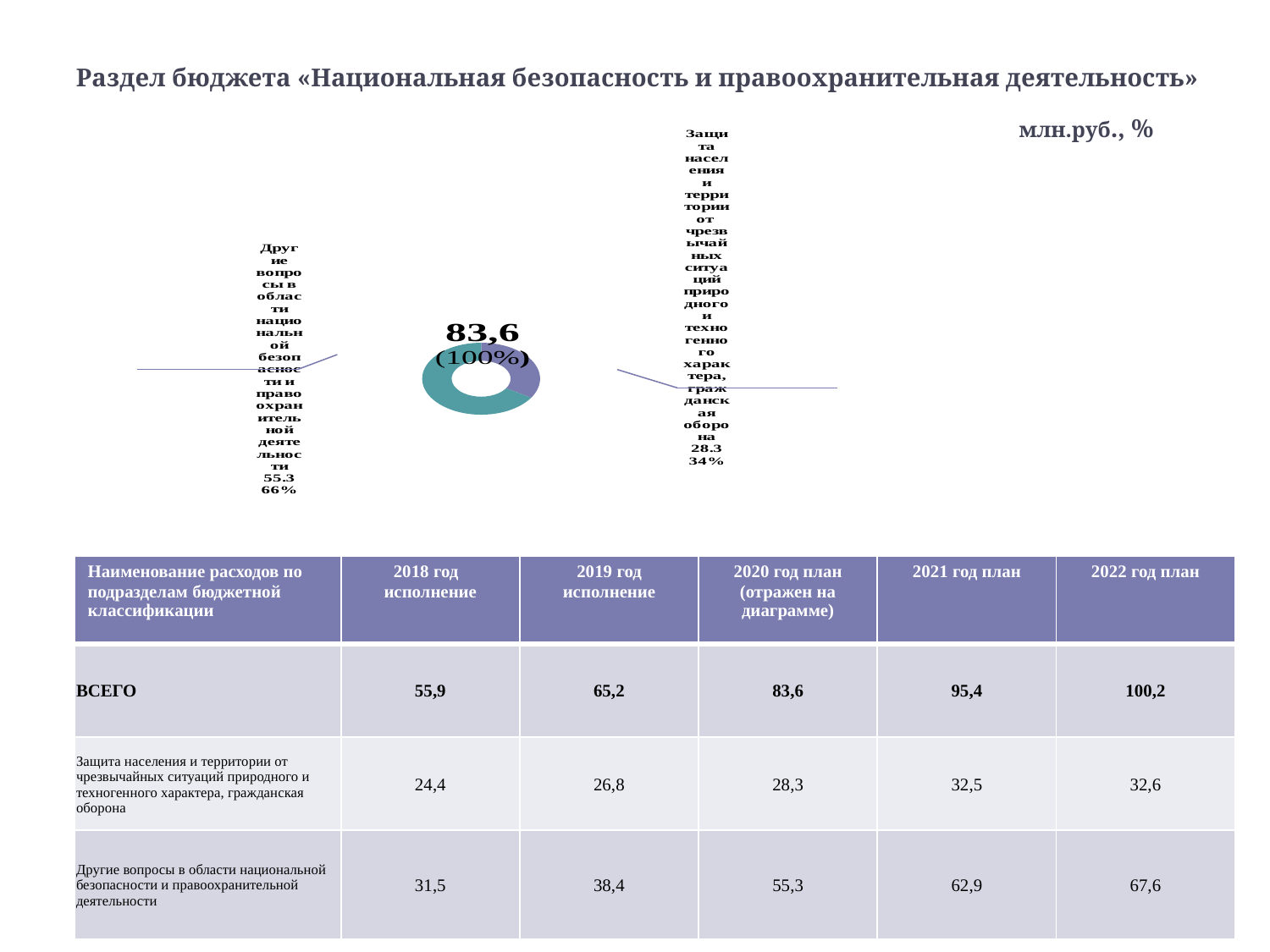
Which slice of the doughnut chart is the smallest? Защита населения и территории от чрезвычайных ситуаций природного и техногенного характера, гражданская оборона What share of the doughnut does 'Защита населения и территории от чрезвычайных ситуаций природного и техногенного характера, гражданская оборона' take? 34% What total value is printed in the centre of the doughnut chart? 83,6 (100%) What value is shown for the slice 'Другие вопросы в области национальной безопасности и правоохранительной деятельности'? 55.3 What share of the doughnut does 'Другие вопросы в области национальной безопасности и правоохранительной деятельности' take? 66% What kind of chart is shown on the slide? doughnut (pie) chart What units are indicated for the chart in the top-right corner? млн.руб., % Which slice of the doughnut chart is the largest? Другие вопросы в области национальной безопасности и правоохранительной деятельности Which is larger: the slice for 'Другие вопросы...' or the slice for 'Защита населения...'? Другие вопросы в области национальной безопасности и правоохранительной деятельности What is the difference between the values of the two slices (55.3 and 28.3)? 27.0 What value is shown for the slice 'Защита населения и территории от чрезвычайных ситуаций природного и техногенного характера, гражданская оборона'? 28.3 How many slices does the doughnut chart have? 2